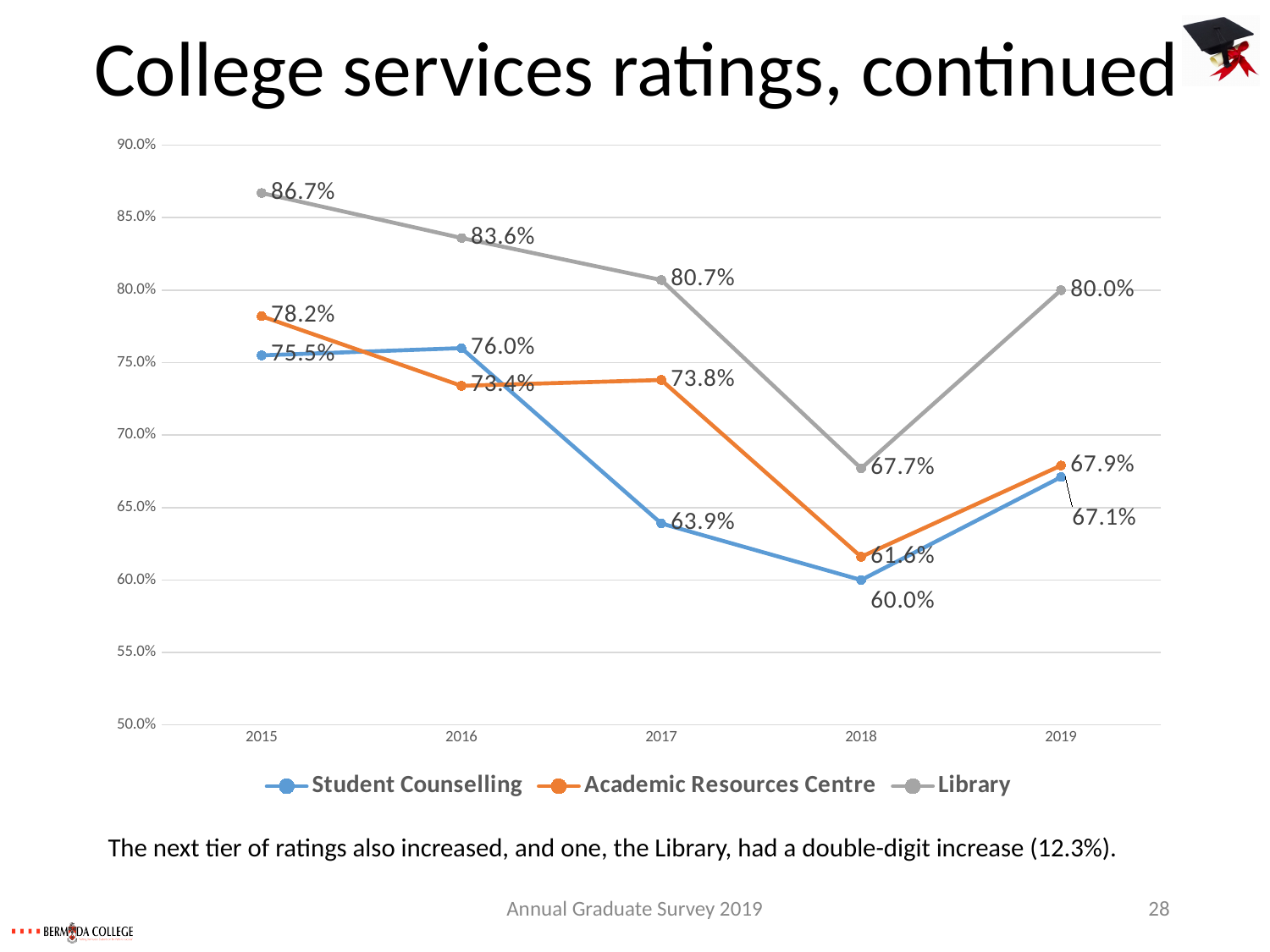
What was the Library rating in 2015? 86.7% In 2016, which had the higher rating: Student Counselling or Academic Resources Centre? Student Counselling How many series does the legend list? 3 In which year was the Student Counselling rating lowest? 2018 What was the Academic Resources Centre rating in 2019? 67.9% What was the Academic Resources Centre rating in 2017? 73.8% What was the Student Counselling rating in 2018? 60.0% In which year was the Library rating highest? 2015 What kind of chart is shown on the slide? Line chart What is the difference between the Academic Resources Centre ratings in 2015 and 2016? 4.8% How many years are shown on the x axis? 5 By how many percentage points did the Library rating increase from 2018 to 2019? 12.3%